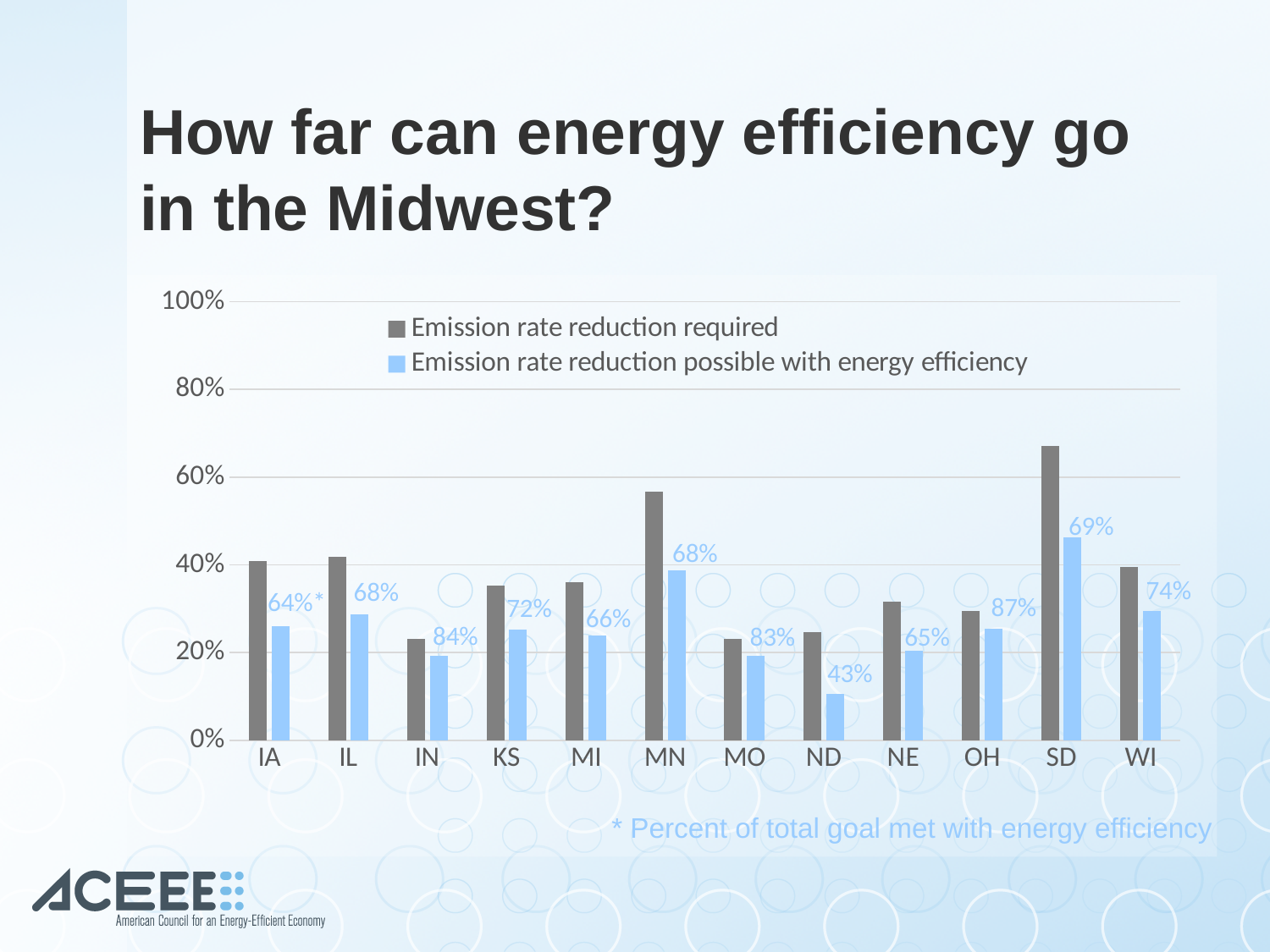
According to the label above its bar, what percent of the total goal is met with energy efficiency in Ohio (OH)? 87% Is the 'Emission rate reduction possible with energy efficiency' value for ND greater or less than 20%? less Which state has the lowest labelled percent of total goal met with energy efficiency? ND Is the 'Emission rate reduction required' value for SD greater or less than 60%? greater According to the label above its bar, what percent of the total goal is met with energy efficiency in North Dakota (ND)? 43% According to the label above its bar, what percent of the total goal is met with energy efficiency in Indiana (IN)? 84% How many series does the chart legend list? 2 What kind of chart is shown on the slide? bar chart Which state has the highest labelled percent of total goal met with energy efficiency? OH Which state has the shortest 'Emission rate reduction possible with energy efficiency' bar? ND Which state has the tallest 'Emission rate reduction required' bar? SD How many states are shown on the x axis of the chart? 12